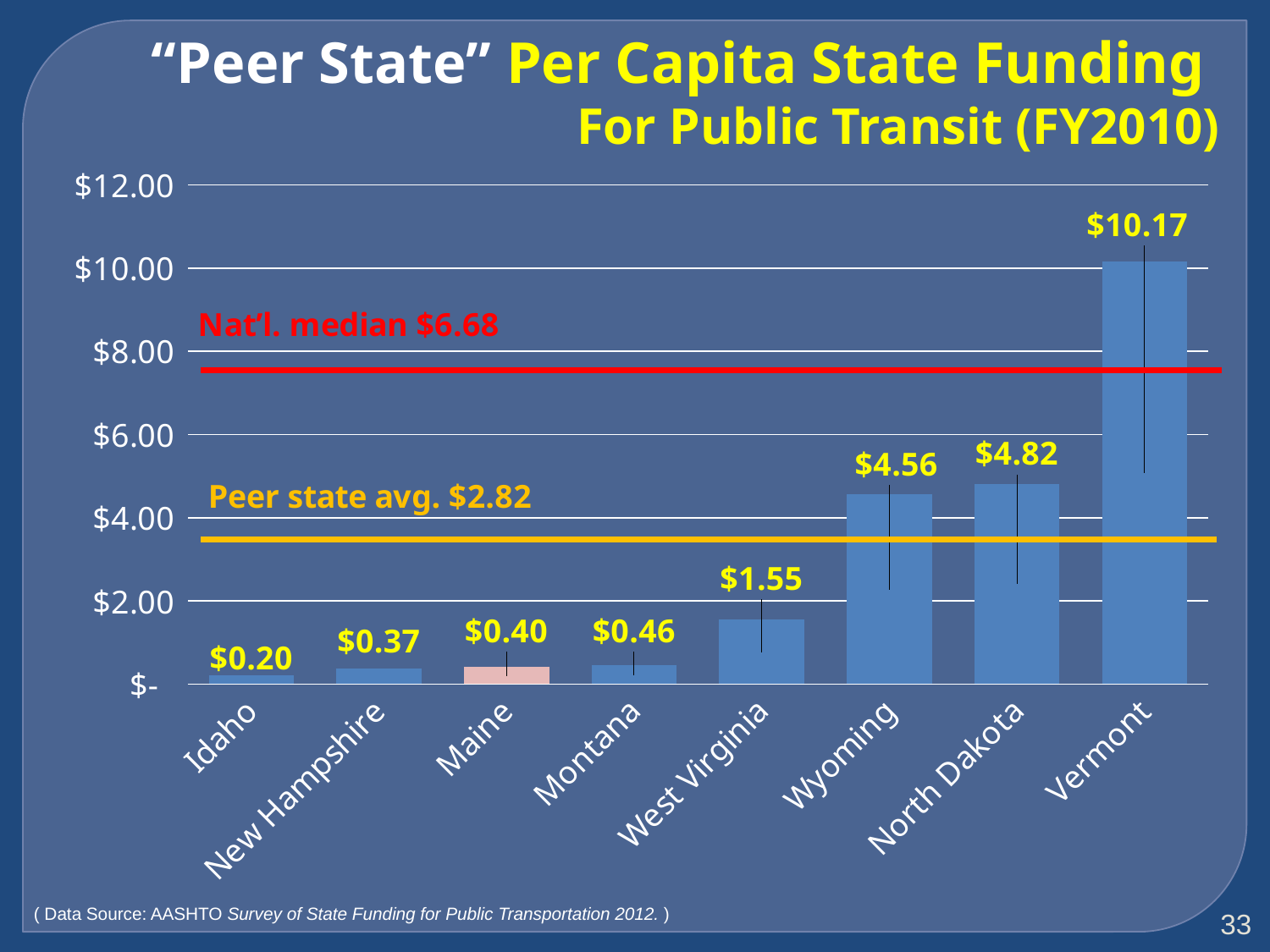
What is the per capita state funding for public transit for Maine? $0.40 How many states are shown in the chart? 8 Which state has the highest per capita state funding for public transit? Vermont What is the peer state average per capita state funding shown on the chart? $2.82 What is the per capita state funding for public transit for West Virginia? $1.55 What is the per capita state funding for public transit for Vermont? $10.17 Which has higher per capita state funding, Montana or New Hampshire? Montana What is the national median per capita state funding shown on the chart? $6.68 Do the values rise or fall from left to right across the states? Rise Which state has the lowest per capita state funding for public transit? Idaho What is the difference between North Dakota's and Wyoming's per capita state funding? $0.26 What kind of chart is shown on the slide? Bar chart